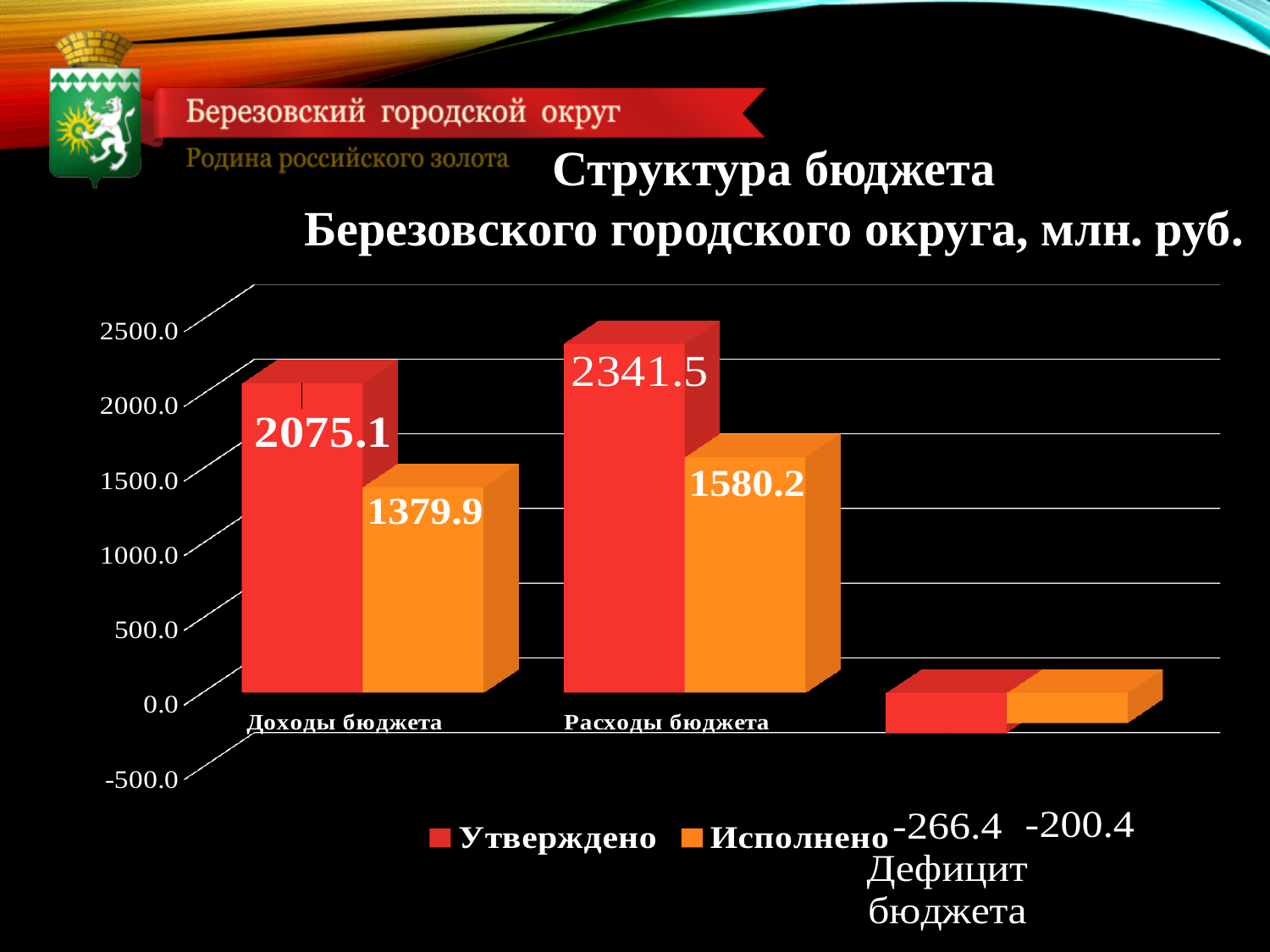
How many categories are shown on the x axis? 3 What is the value of Исполнено for Расходы бюджета? 1580.2 What is the difference between the Утверждено and Исполнено values for Расходы бюджета? 761.3 What is the value of Утверждено for Доходы бюджета? 2075.1 How many series does the legend list? 2 Which category has the lowest Исполнено value? Дефицит бюджета Which category has the highest Утверждено value? Расходы бюджета Which is larger: the Исполнено value for Доходы бюджета or the Исполнено value for Расходы бюджета? Расходы бюджета Which colour represents the Исполнено series? Orange What kind of chart is shown on the slide? Bar chart What is the value of Исполнено for Доходы бюджета? 1379.9 What is the value of Утверждено for Дефицит бюджета? -266.4